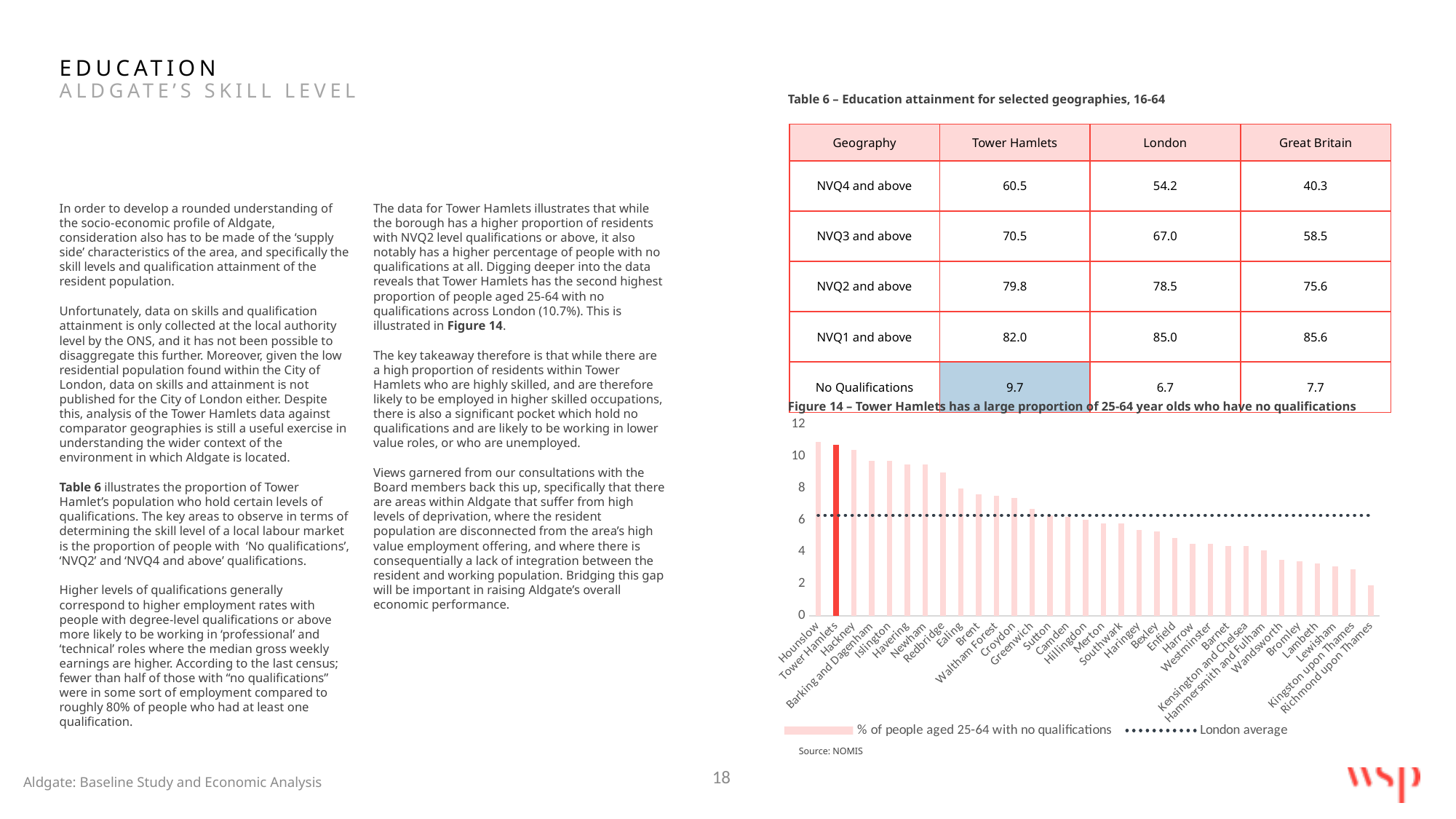
In Figure 14, do the bar values rise or fall from left to right along the x axis? Fall In Figure 14, is the value for Islington greater or less than 8? greater What kind of chart is Figure 14? Bar chart In Figure 14, is the value for Richmond upon Thames greater or less than 4? less In Figure 14, which borough has the highest proportion of people aged 25-64 with no qualifications? Hounslow How many boroughs are plotted in Figure 14? 32 In Figure 14, which bar is highlighted in a darker red colour? Tower Hamlets In Figure 14, which borough has the lowest proportion of people aged 25-64 with no qualifications? Richmond upon Thames What does the dotted horizontal line in Figure 14 represent, according to the legend? London average How many entries does the legend of Figure 14 list? 2 In Figure 14, is the value for Hounslow greater or less than 10? greater In Figure 14, which has the larger value, Camden or Bromley? Camden